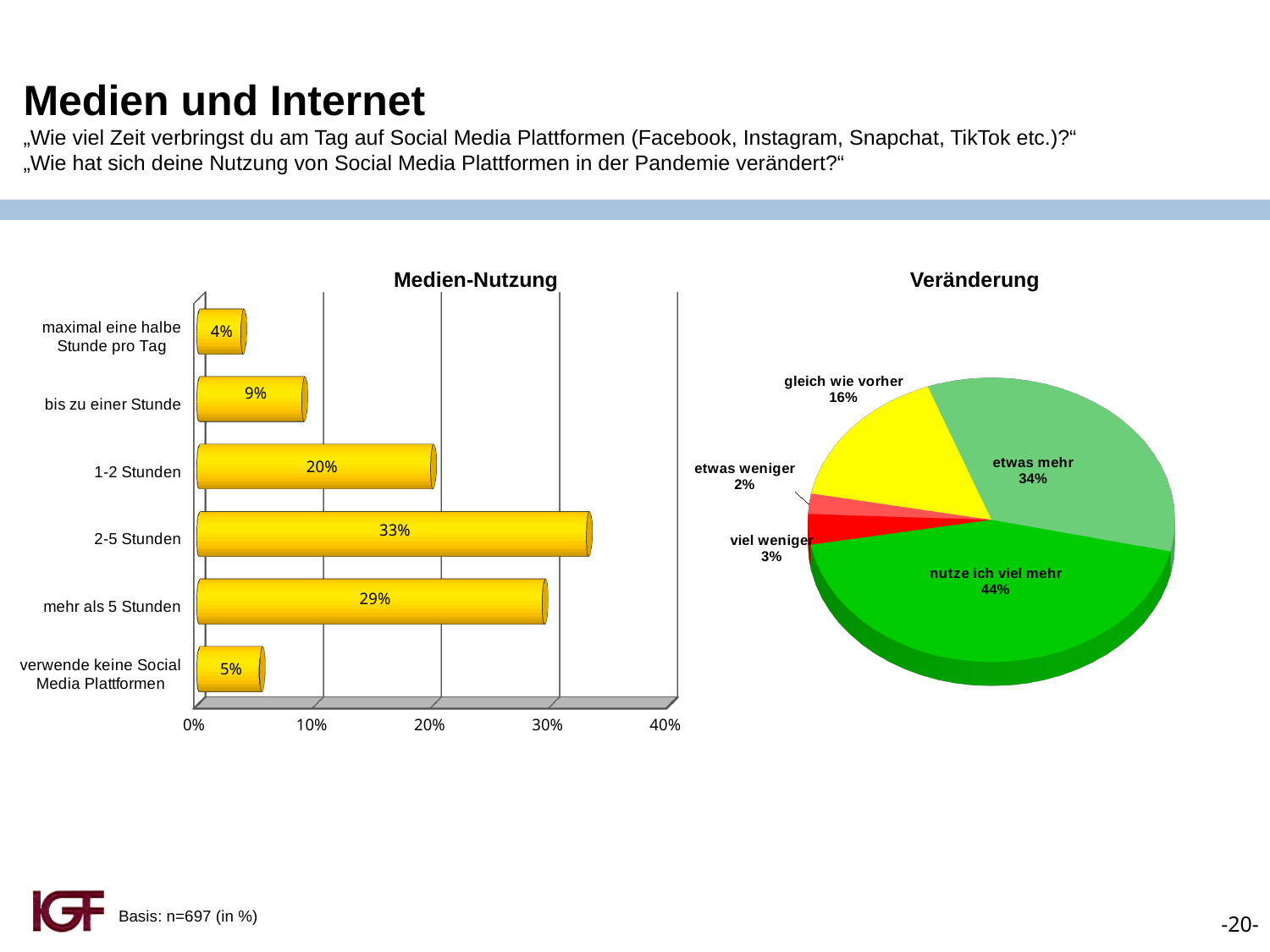
In the "Veränderung" chart, what is the share for "nutze ich viel mehr"? 44% What kind of chart is the "Medien-Nutzung" chart? bar chart In the "Veränderung" chart, which slice is the smallest? etwas weniger In the "Veränderung" chart, what is the value for "gleich wie vorher"? 16% What kind of chart is the "Veränderung" chart? pie chart In the "Medien-Nutzung" chart, what is the value for "2-5 Stunden"? 33% In the "Medien-Nutzung" chart, what is the difference between "2-5 Stunden" and "mehr als 5 Stunden"? 4% In the "Medien-Nutzung" chart, which category has the highest value? 2-5 Stunden In the "Medien-Nutzung" chart, what is the value for "bis zu einer Stunde"? 9% In the "Medien-Nutzung" chart, how many categories are shown? 6 In the "Medien-Nutzung" chart, which category has the lowest value? maximal eine halbe Stunde pro Tag In the "Veränderung" chart, which is larger: "etwas mehr" or "gleich wie vorher"? etwas mehr